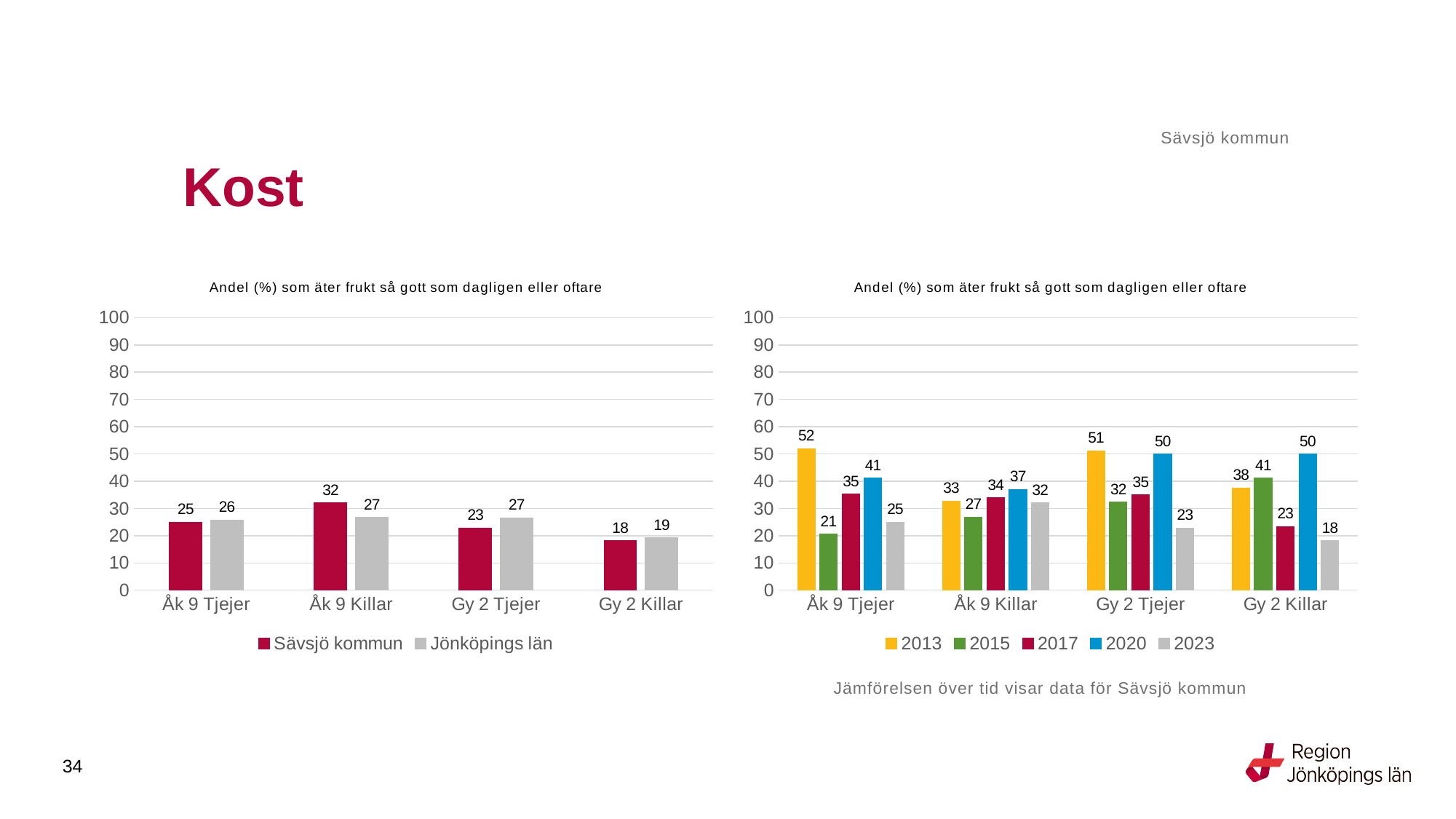
What kind of chart is the right chart? Bar chart In the right chart, what is the value for 2013 for Åk 9 Tjejer? 52 In the left chart, what is the value for Jönköpings län for Gy 2 Tjejer? 27 In the left chart, which category has the lowest value for Sävsjö kommun? Gy 2 Killar In the right chart, how many series does the legend list? 5 In the right chart, which is larger for Åk 9 Killar: the value for 2015 or the value for 2020? 2020 In the left chart, what is the difference between Sävsjö kommun and Jönköpings län for Åk 9 Killar? 5 In the left chart, what is the value for Sävsjö kommun for Åk 9 Killar? 32 In the right chart, what is the difference between the 2013 and 2023 values for Gy 2 Tjejer? 28 In the left chart, how many series does the legend list? 2 In the right chart, which year has the highest value for Gy 2 Killar? 2020 In the right chart, what is the value for 2023 for Gy 2 Killar? 18